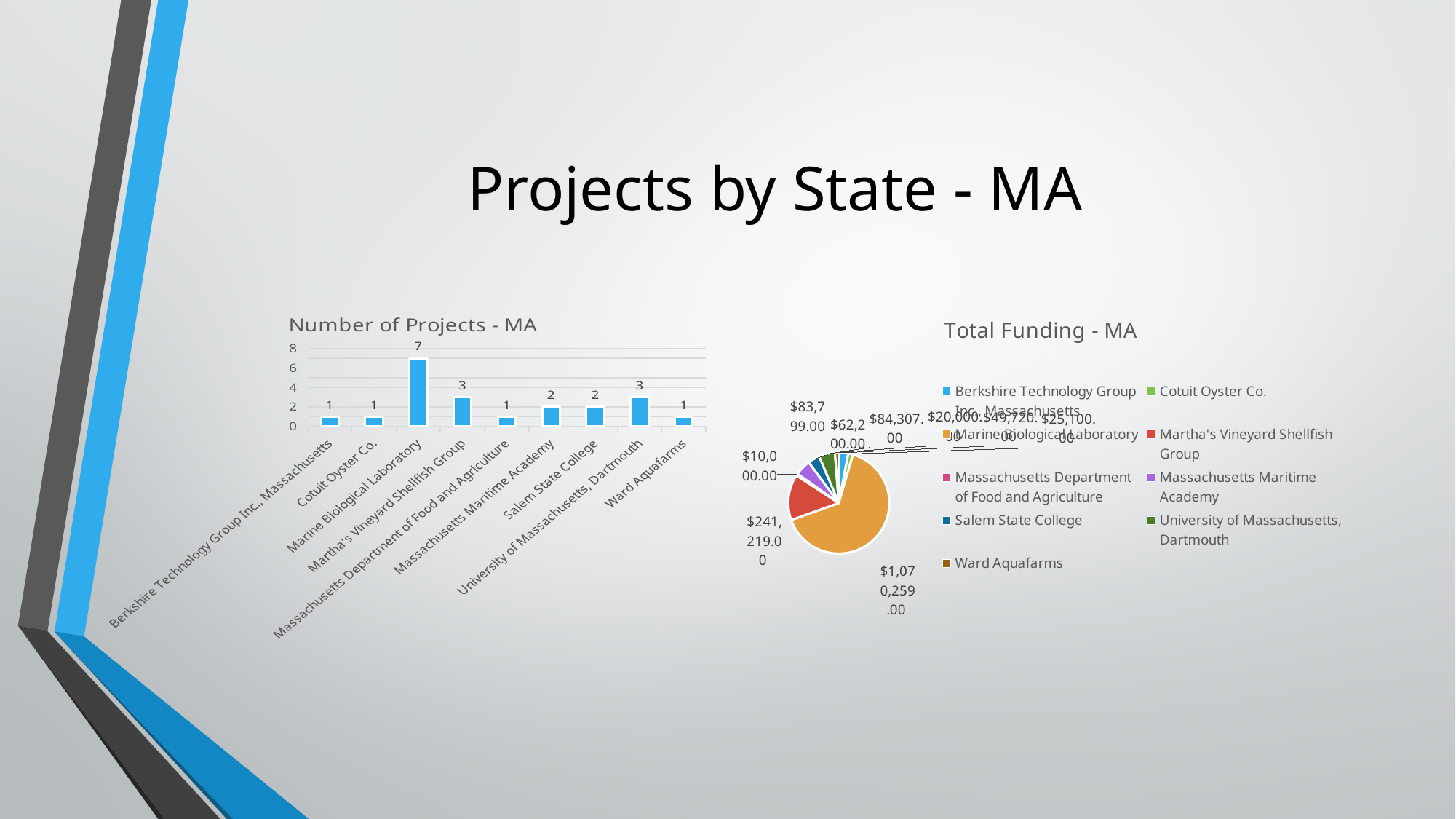
How many organizations are shown in the 'Number of Projects - MA' chart? 9 How many entries does the legend of the 'Total Funding - MA' chart list? 9 In the 'Number of Projects - MA' chart, how many projects does Marine Biological Laboratory have? 7 In the 'Total Funding - MA' chart, what is the value of the largest slice? $1,070,259.00 What type of chart is 'Number of Projects - MA'? Bar chart In the 'Number of Projects - MA' chart, which has more projects: Massachusetts Maritime Academy or Ward Aquafarms? Massachusetts Maritime Academy In the 'Number of Projects - MA' chart, which organization has the highest number of projects? Marine Biological Laboratory In the 'Total Funding - MA' chart, which organization has the largest slice? Marine Biological Laboratory What type of chart is 'Total Funding - MA'? Pie chart In the 'Number of Projects - MA' chart, what is the difference between the number of projects for Marine Biological Laboratory and University of Massachusetts, Dartmouth? 4 In the 'Number of Projects - MA' chart, how many projects does Salem State College have? 2 In the 'Number of Projects - MA' chart, how many projects does Martha's Vineyard Shellfish Group have? 3